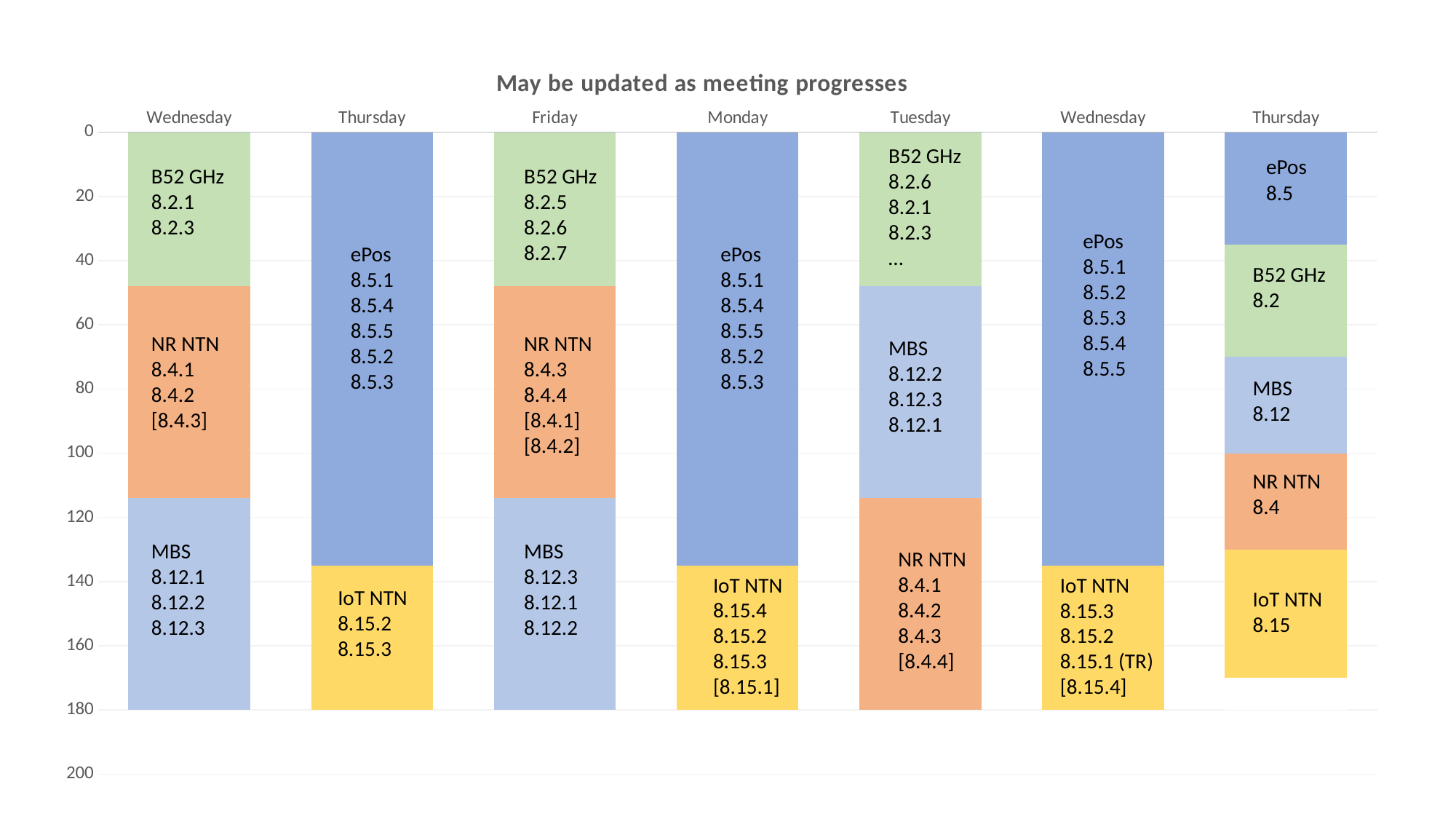
Is the MBS segment in the Tuesday bar greater or less than 40? greater What is the title of the chart? May be updated as meeting progresses Which topic occupies the top segment of the Monday bar? ePos Which day's bar is the shortest in total? the last Thursday How many segments make up the first Thursday bar? 2 What kind of chart is shown on the slide? stacked bar chart Is the B52 GHz segment in the first Wednesday bar greater or less than 60? less Is the ePos segment in the first Thursday bar greater or less than 100? greater How many day categories are shown along the x axis? 7 How many segments make up the last Thursday bar? 5